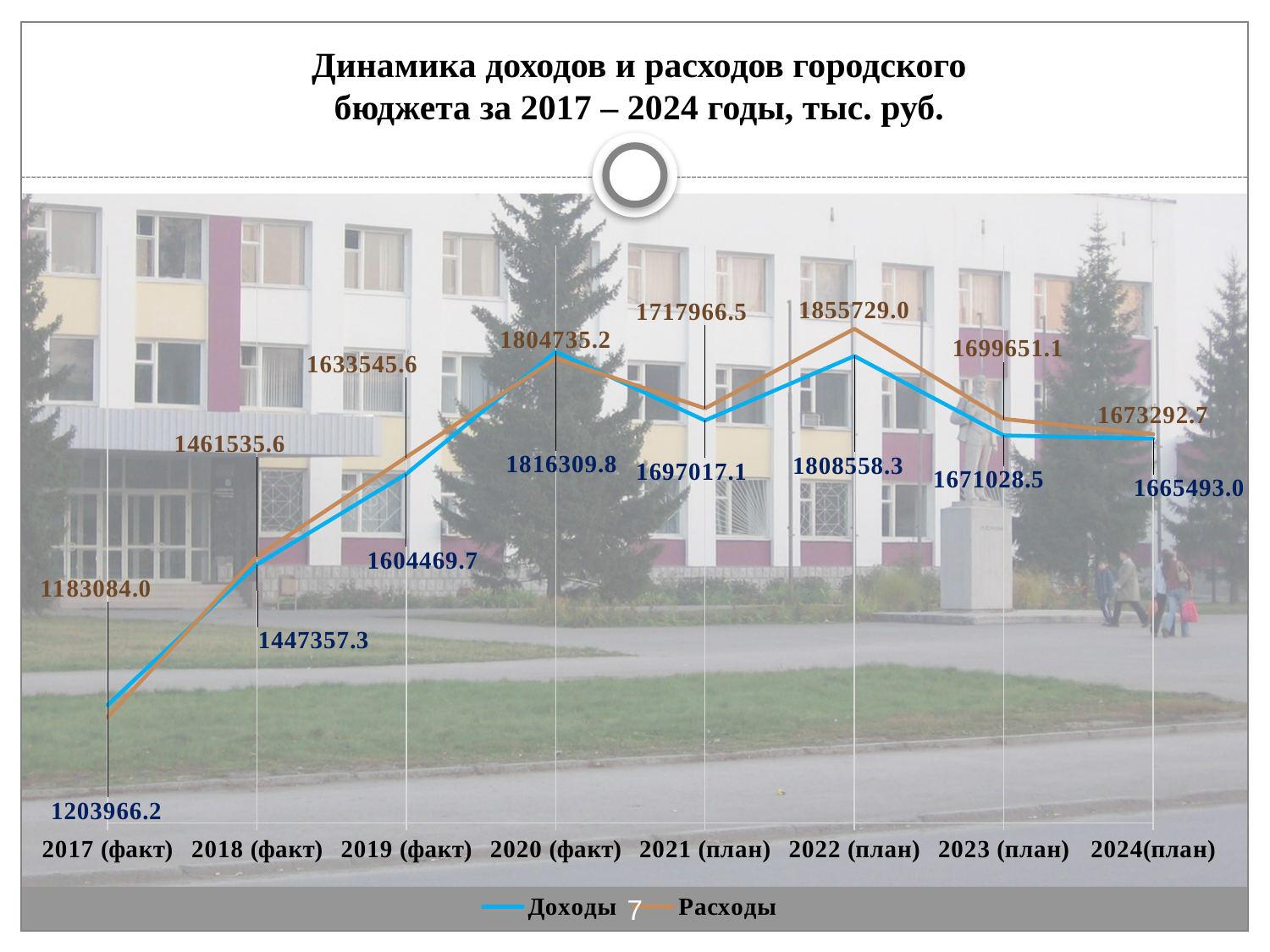
What is the value of Доходы for 2024(план)? 1665493.0 How many years are shown on the x axis? 8 What is the value of Расходы for 2019 (факт)? 1633545.6 Does Доходы rise or fall from 2017 (факт) to 2020 (факт)? rise What is the difference between Расходы and Доходы in 2022 (план)? 47170.7 What is the value of Расходы for 2022 (план)? 1855729.0 In which year is Расходы highest? 2022 (план) What is the value of Доходы for 2017 (факт)? 1203966.2 What kind of chart is this? line chart How many series does the legend list? 2 In which year is Доходы lowest? 2017 (факт) Which is larger in 2017 (факт), Доходы or Расходы? Доходы